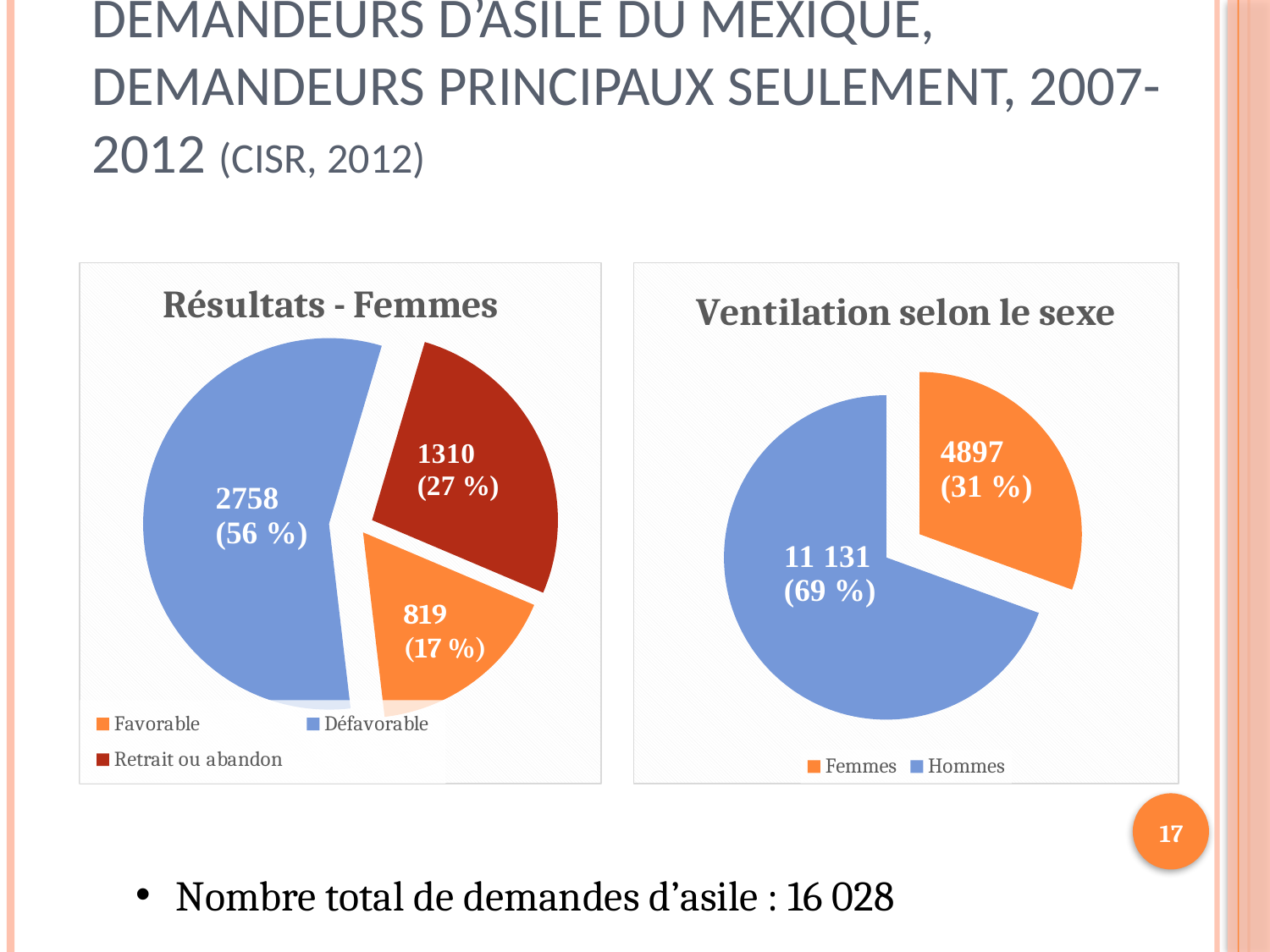
In the 'Ventilation selon le sexe' chart, what is the value for Hommes? 11 131 In the 'Résultats - Femmes' chart, what is the difference between Défavorable and Retrait ou abandon? 1448 In the 'Ventilation selon le sexe' chart, what is the value for Femmes? 4897 How many categories does the 'Résultats - Femmes' chart show? 3 In the 'Résultats - Femmes' chart, what is the value for Favorable? 819 In the 'Résultats - Femmes' chart, what is the value for Défavorable? 2758 In the 'Ventilation selon le sexe' chart, what share of the pie is Femmes? 31 % In the 'Résultats - Femmes' chart, which category has the largest slice? Défavorable What type of chart is 'Ventilation selon le sexe'? Pie chart In the 'Résultats - Femmes' chart, what is the value for Retrait ou abandon? 1310 In the 'Résultats - Femmes' chart, what share of the pie is Retrait ou abandon? 27 % In the 'Résultats - Femmes' chart, which category has the smallest slice? Favorable